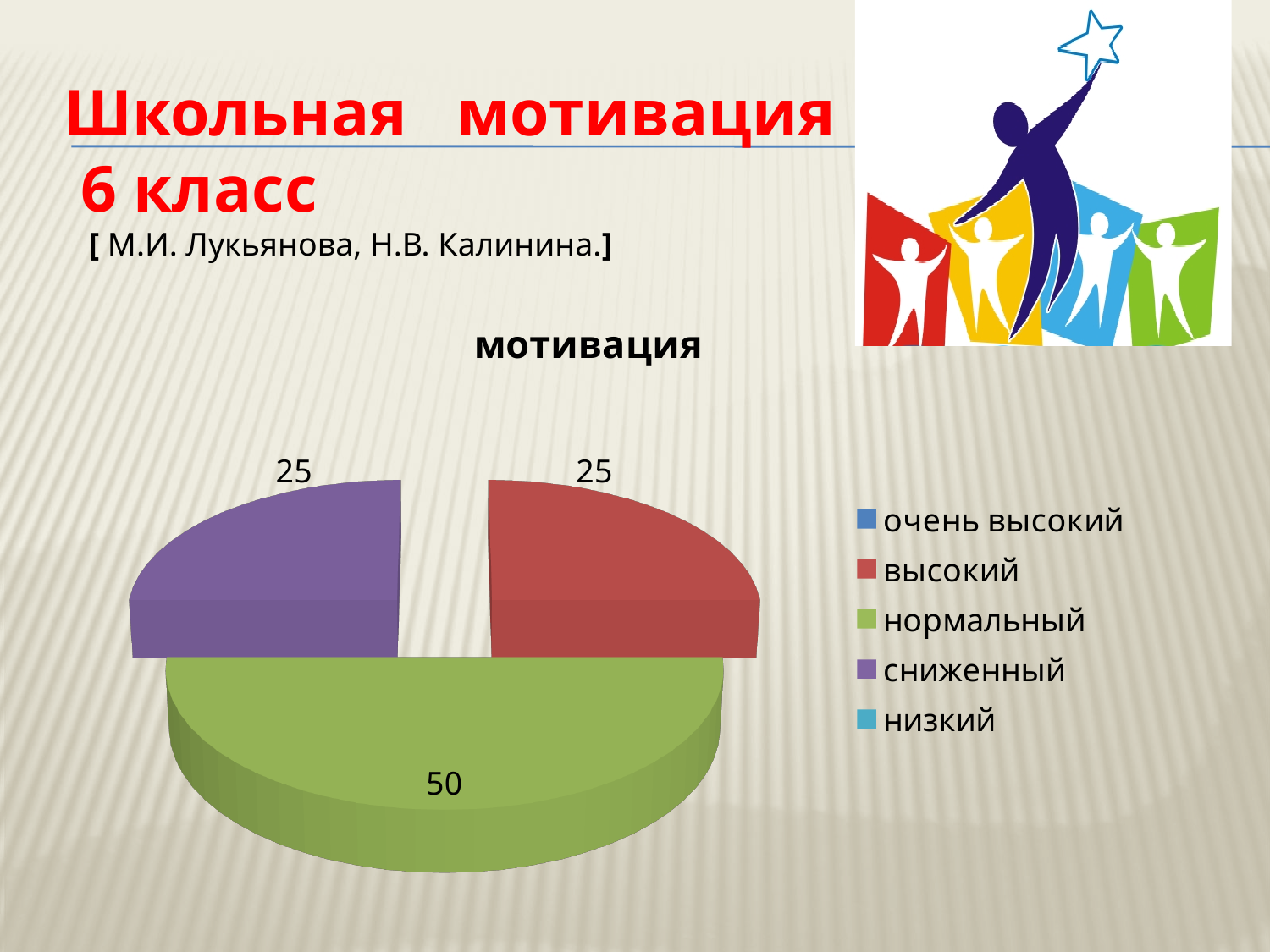
Which is larger, the value for "нормальный" or the value for "сниженный"? нормальный What share of the pie does the "нормальный" slice represent? 50% How many slices are visible in the "мотивация" pie chart? 3 What is the value for the "нормальный" slice in the "мотивация" chart? 50 What kind of chart is shown on the slide? pie chart What is the title of the chart on the slide? мотивация What is the difference between the values for "нормальный" and "высокий"? 25 What is the value for the "сниженный" slice in the "мотивация" chart? 25 How many categories does the legend of the "мотивация" chart list? 5 What is the value for the "высокий" slice in the "мотивация" chart? 25 Which category has the largest slice in the "мотивация" chart? нормальный What colour is the "нормальный" slice in the chart? green